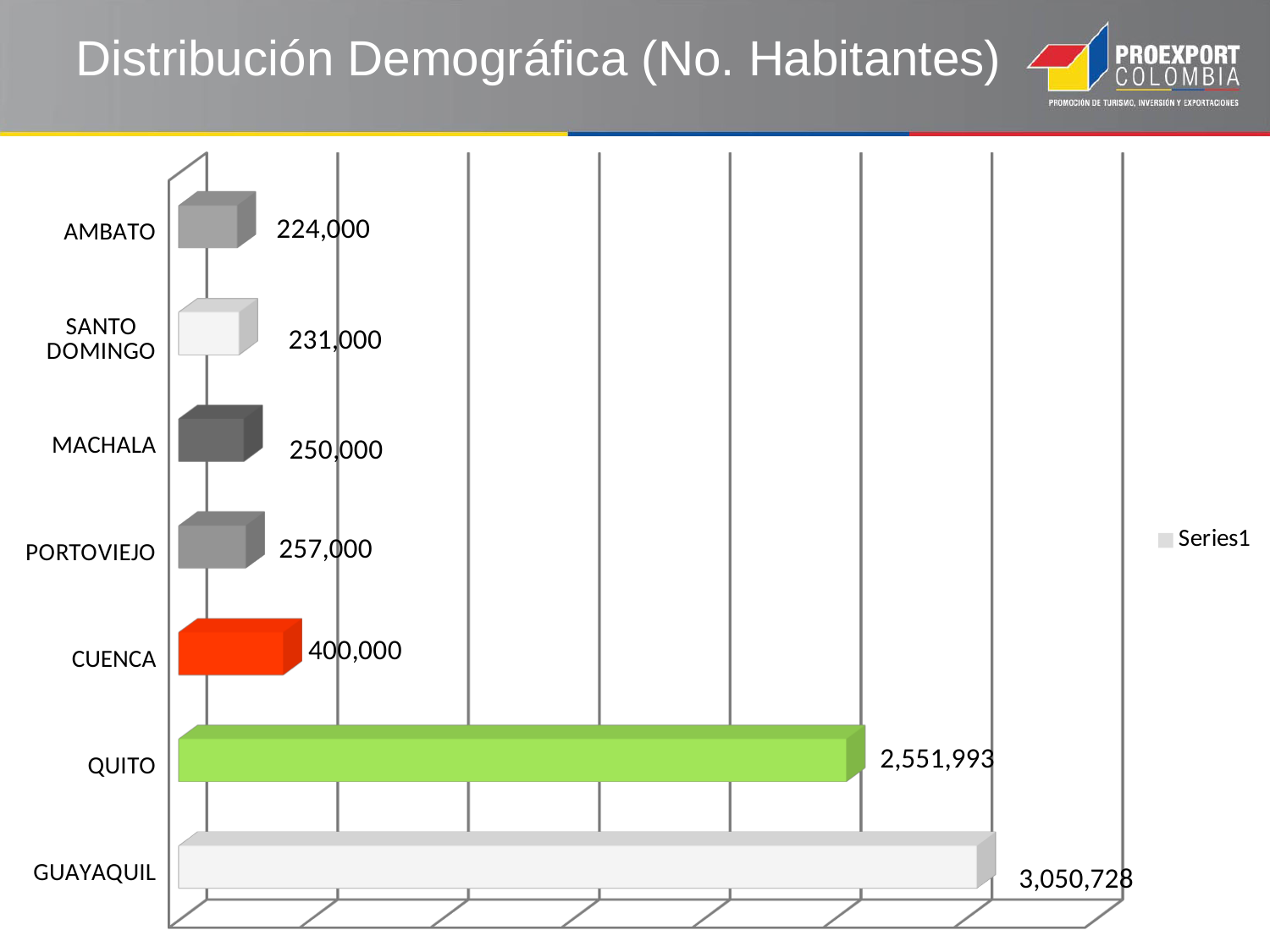
What is the difference between the values for CUENCA and PORTOVIEJO? 143,000 What is the title of the slide? Distribución Demográfica (No. Habitantes) What is the value for SANTO DOMINGO? 231,000 What kind of chart is shown on the slide? Bar chart Which category has the lowest value? AMBATO What is the value for QUITO? 2,551,993 Which is larger, the value for MACHALA or the value for AMBATO? MACHALA What is the value for GUAYAQUIL? 3,050,728 How many categories are shown in the chart? 7 What is the value for CUENCA? 400,000 Which category has the highest value? GUAYAQUIL What is the difference between the values for GUAYAQUIL and QUITO? 498,735